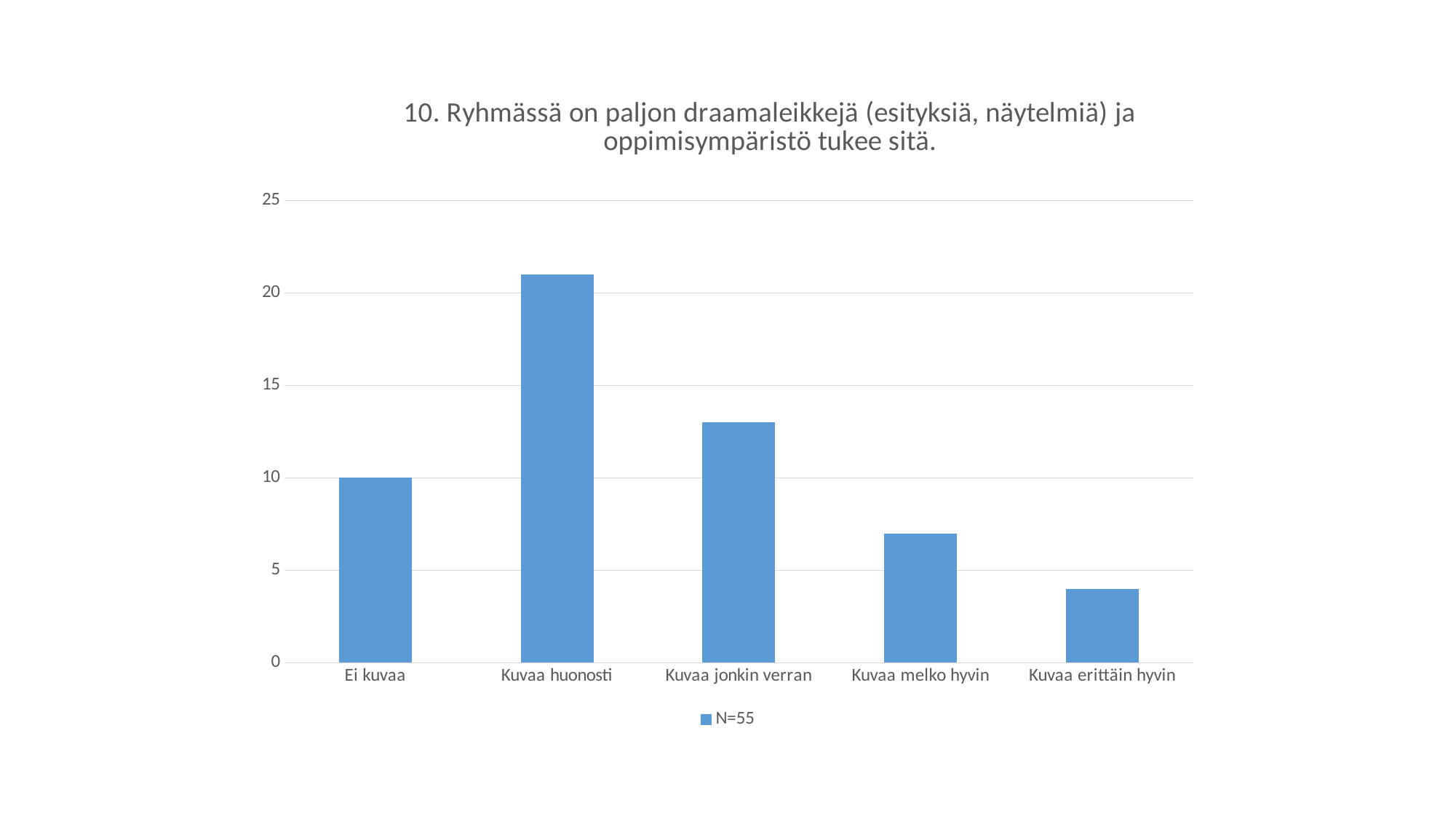
Is the value for Kuvaa erittäin hyvin greater or less than 5? less Which is larger, the value for Kuvaa jonkin verran or the value for Kuvaa melko hyvin? Kuvaa jonkin verran What kind of chart is shown on the slide? bar chart How many series does the legend list? 1 What is the legend entry shown below the chart? N=55 Which category has the highest value? Kuvaa huonosti Is the value for Kuvaa melko hyvin greater or less than 5? greater How many categories are shown on the x axis? 5 Is the value for Kuvaa huonosti greater or less than 20? greater Which category has the lowest value? Kuvaa erittäin hyvin What is the value for Ei kuvaa? 10